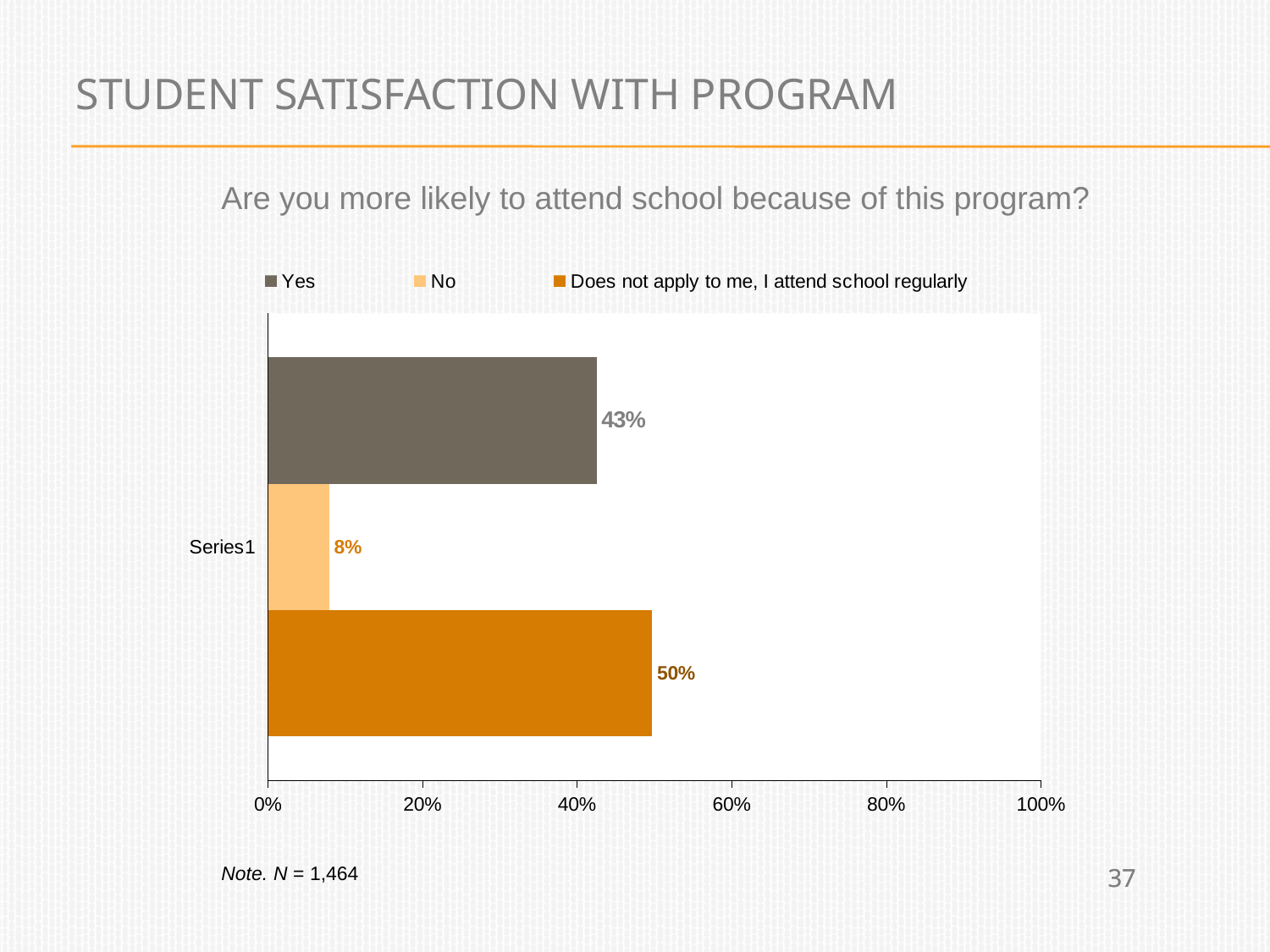
Is the value for "Yes" greater or less than 40%? greater What is the difference in percentage points between the "Yes" and "No" responses? 35 percentage points Which response has the lowest percentage? No Which response has the highest percentage? Does not apply to me, I attend school regularly What percentage of students answered "Does not apply to me, I attend school regularly"? 50% Which is larger, the percentage for "Yes" or the percentage for "No"? Yes What kind of chart is shown on the slide? Bar chart What percentage of students answered "No"? 8% What is the difference in percentage points between "Does not apply to me, I attend school regularly" and "Yes"? 7 percentage points What question is the chart about, as shown above the chart? Are you more likely to attend school because of this program? What percentage of students answered "Yes" to being more likely to attend school because of this program? 43% How many series does the legend list? 3